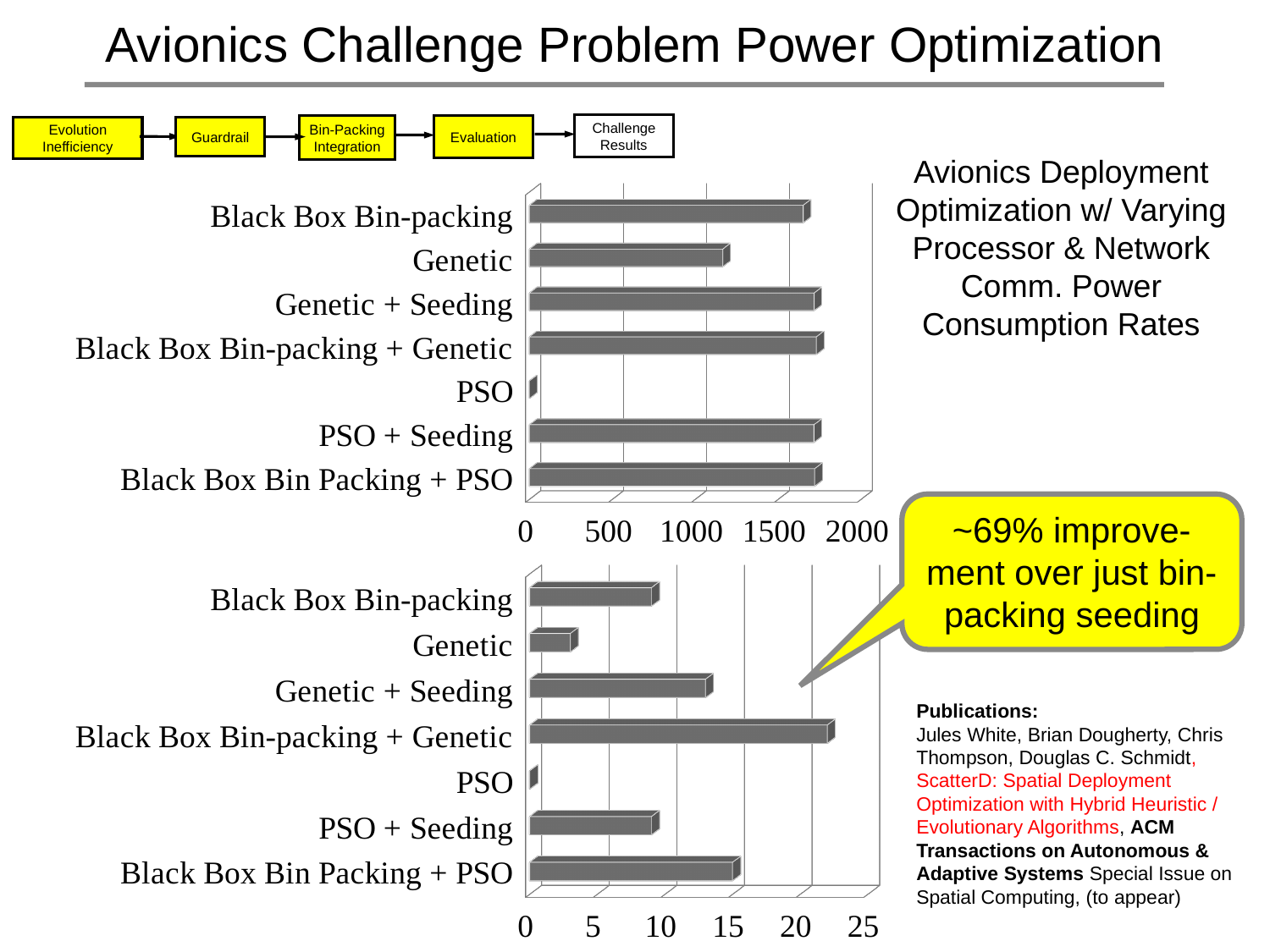
In the top chart, is the value for Black Box Bin-packing greater or less than 1500? greater In the bottom chart, which is larger: Black Box Bin-packing + Genetic or Black Box Bin Packing + PSO? Black Box Bin-packing + Genetic In the top chart, is the value for Genetic greater or less than 1500? less In the bottom chart, which category has the lowest value? PSO In the top chart, which is larger: Black Box Bin-packing or Genetic? Black Box Bin-packing In the bottom chart, is the value for Genetic greater or less than 5? less How many categories does the top chart show? 7 In the top chart, which category has the lowest value? PSO What kind of chart is the top chart on the slide? bar chart In the bottom chart, which category has the highest value? Black Box Bin-packing + Genetic How many categories does the bottom chart show? 7